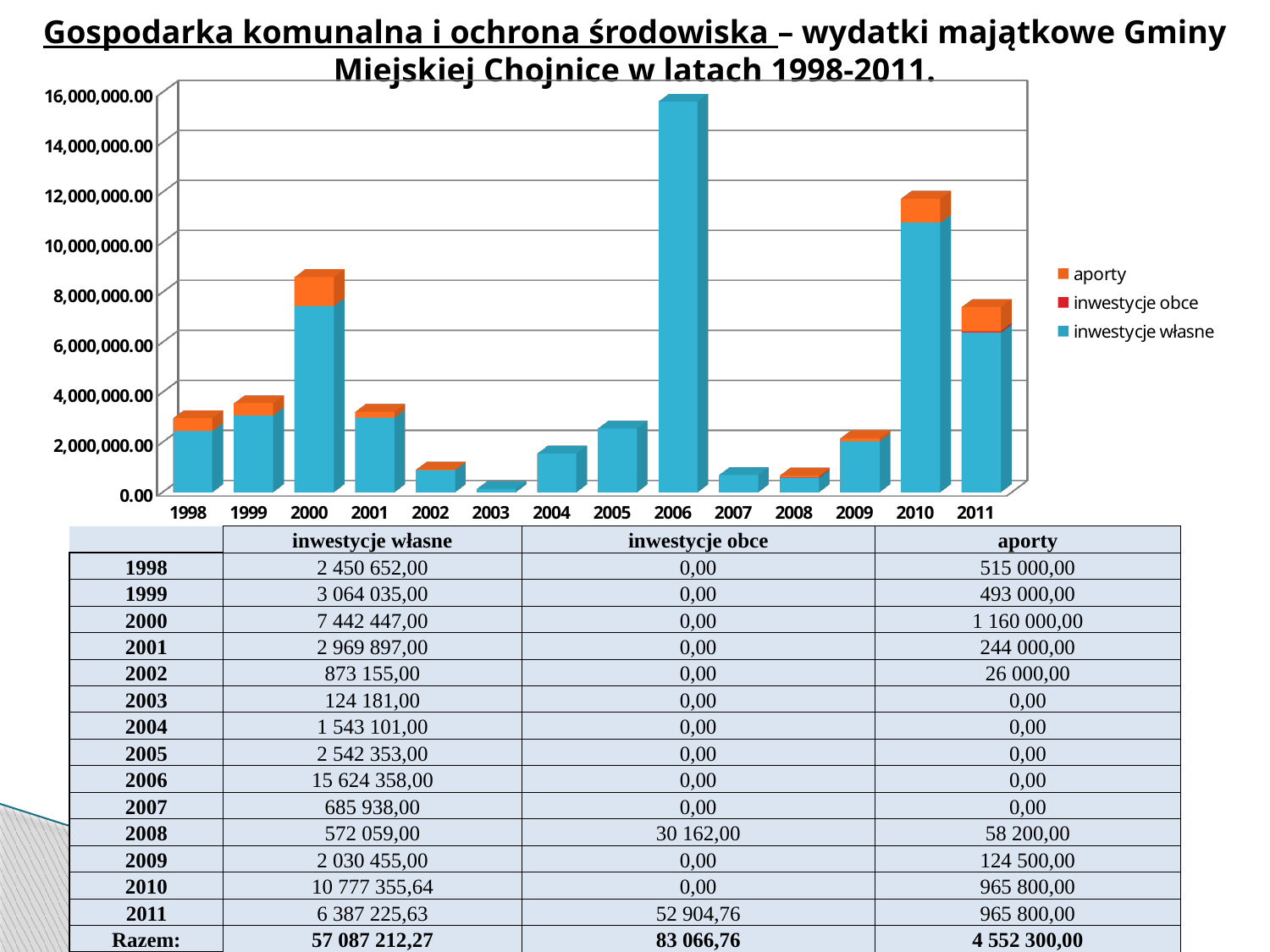
What is the total of the stacked bar for 2008? 660 421,00 What is the difference between inwestycje własne in 2006 and in 2010? 4 847 002,36 Is the total bar for 2006 greater or less than 14,000,000.00? greater In which year is inwestycje własne the lowest? 2003 How many series does the chart legend list? 3 How many years are shown on the x axis of the chart? 14 Which year has the larger total bar, 2000 or 2011? 2000 What is the value of inwestycje obce for 2011? 52 904,76 What is the value of aporty for 2000? 1 160 000,00 What type of chart is shown on the slide? stacked bar chart In which year is inwestycje własne the highest? 2006 What is the value of inwestycje własne for 2006? 15 624 358,00